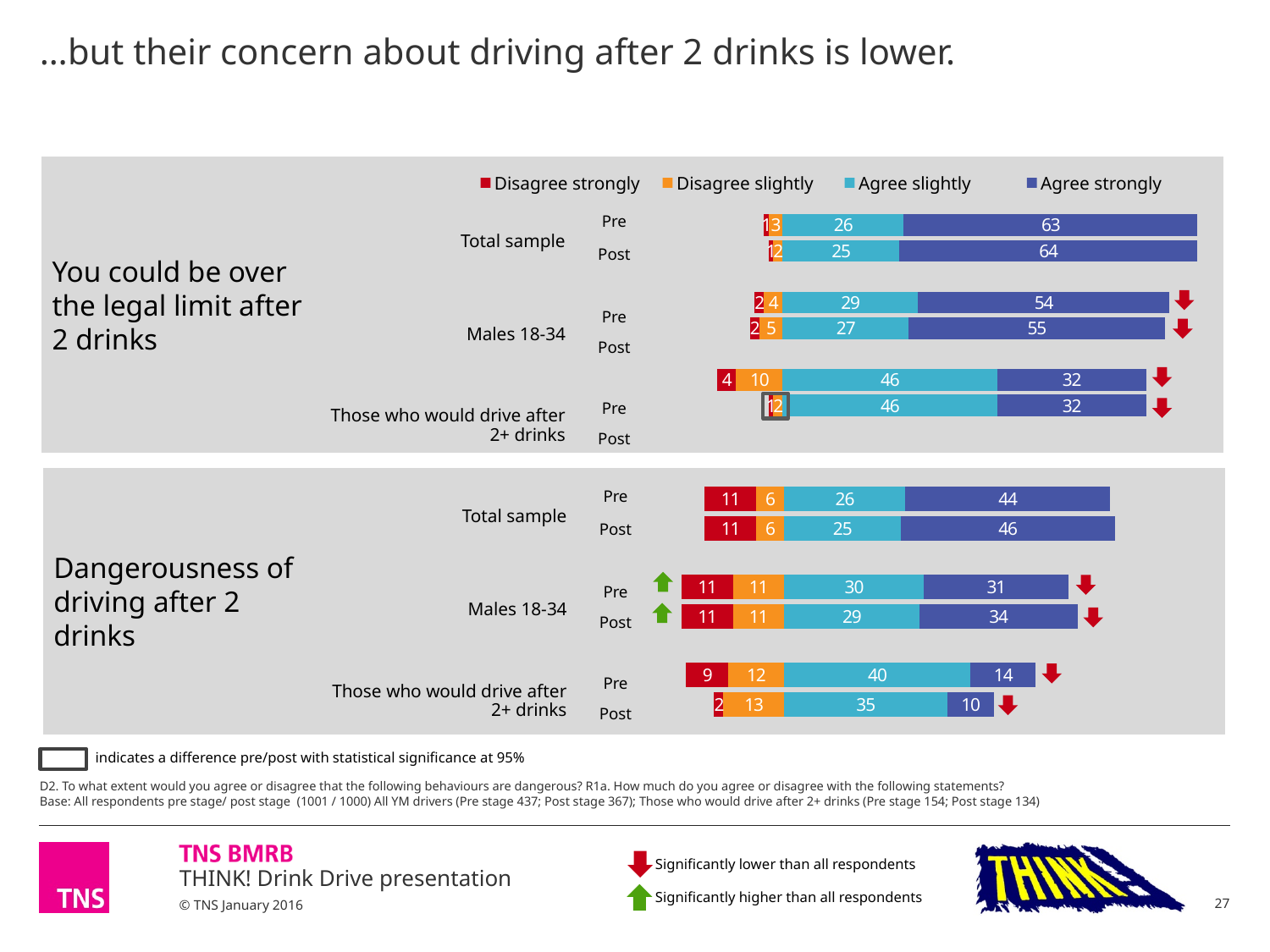
In the 'You could be over the legal limit after 2 drinks' chart, which group has the lowest Agree strongly value at Pre? Those who would drive after 2+ drinks In the 'Dangerousness of driving after 2 drinks' chart, is the Agree slightly value for Those who would drive after 2+ drinks larger at Pre or at Post? Pre In the 'You could be over the legal limit after 2 drinks' chart, what is the Agree strongly value for the Total sample Post bar? 64 In the 'You could be over the legal limit after 2 drinks' chart, what is the difference between the Agree strongly values for Males 18-34 Post and Males 18-34 Pre? 1 In the 'Dangerousness of driving after 2 drinks' chart, what is the difference between the Agree strongly values for Total sample Post and Total sample Pre? 2 How many series does the legend list? 4 What kind of chart is used on this slide? Stacked bar chart Which legend entry is shown in red? Disagree strongly In the 'Dangerousness of driving after 2 drinks' chart, which group has the highest Agree strongly value at Post? Total sample In the 'Dangerousness of driving after 2 drinks' chart, what is the Disagree slightly value for Those who would drive after 2+ drinks at Post? 13 In the 'Dangerousness of driving after 2 drinks' chart, what is the Agree strongly value for Males 18-34 Post? 34 In the 'You could be over the legal limit after 2 drinks' chart, what is the Agree slightly value for Those who would drive after 2+ drinks at Pre? 46